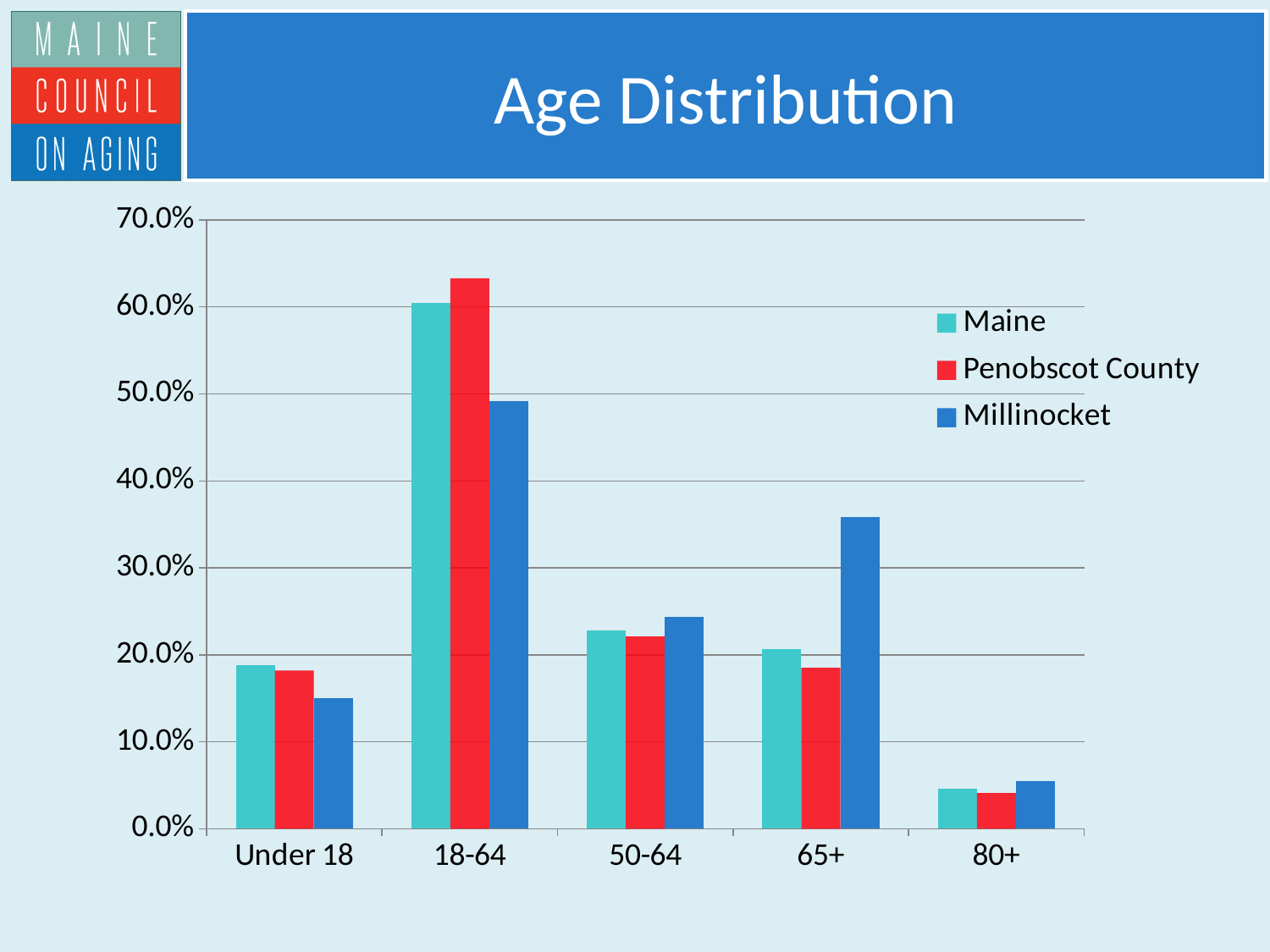
Is the value for Penobscot County in the 18-64 age group greater or less than 60.0%? greater Is the value for Millinocket in the Under 18 age group greater or less than 20.0%? less Which age group has the highest value for Millinocket? 18-64 How many age groups are shown on the x axis? 5 What kind of chart is shown on the slide? bar chart In the 18-64 age group, which is larger: the value for Penobscot County or the value for Millinocket? Penobscot County Which age group has the lowest value for Maine? 80+ Is the value for Millinocket in the 18-64 age group greater or less than 50.0%? less How many series does the legend list? 3 In the 65+ age group, which is larger: the value for Maine or the value for Millinocket? Millinocket What is the title of the slide? Age Distribution